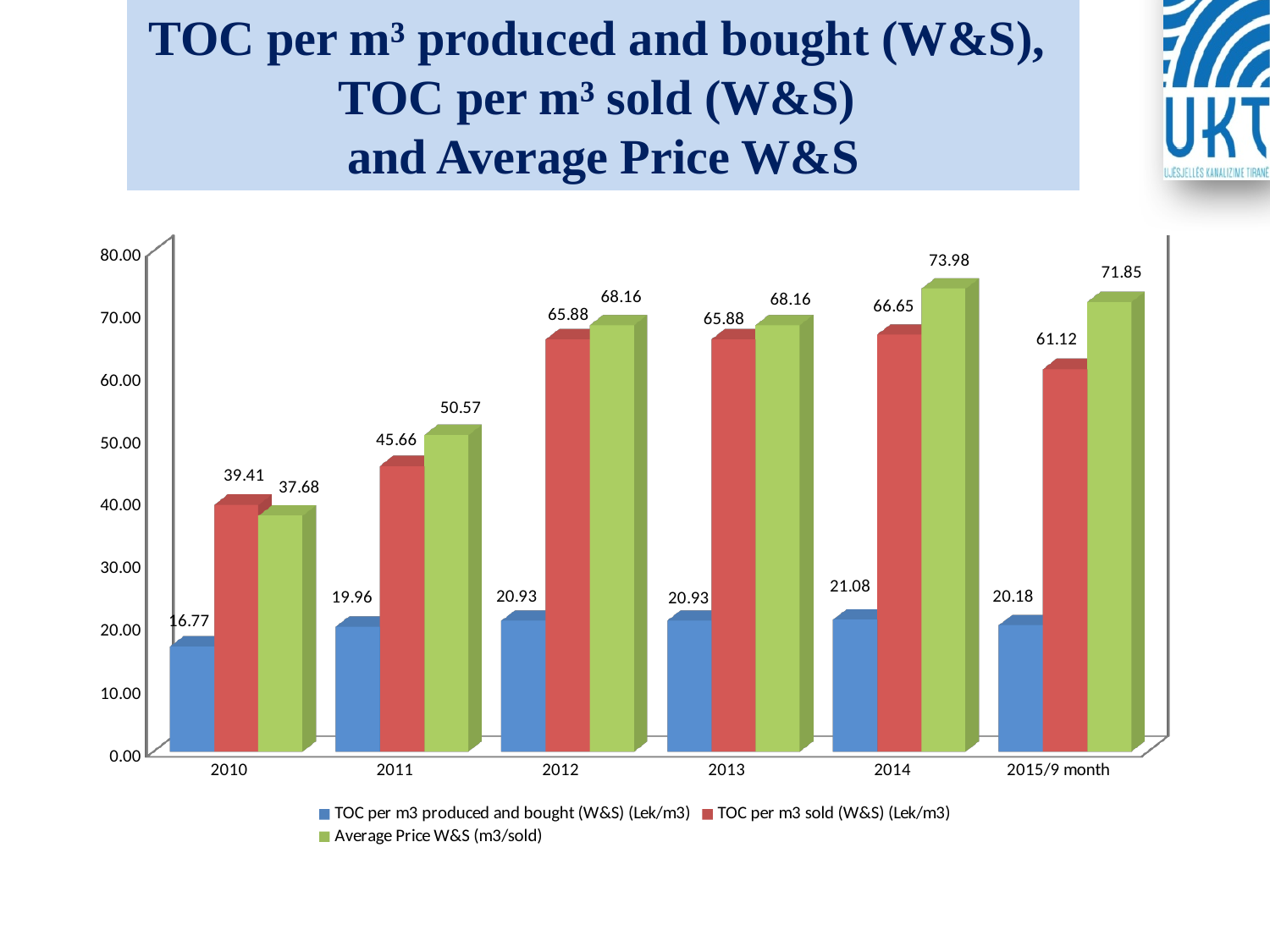
In which year is the Average Price W&S (m3/sold) highest? 2014 How many series does the legend list? 3 What is the value of TOC per m3 sold (W&S) (Lek/m3) for 2014? 66.65 In 2010, which is larger: TOC per m3 sold (W&S) or Average Price W&S? TOC per m3 sold (W&S) How many categories are shown on the x axis? 6 In which year is TOC per m3 produced and bought (W&S) (Lek/m3) lowest? 2010 Does the Average Price W&S (m3/sold) rise or fall from 2010 to 2014? Rise What is the value of TOC per m3 produced and bought (W&S) (Lek/m3) for 2015/9 month? 20.18 What kind of chart is shown on the slide? Bar chart What colour are the bars for Average Price W&S (m3/sold)? Green What is the Average Price W&S (m3/sold) for 2011? 50.57 What is the difference between the Average Price W&S and TOC per m3 sold (W&S) in 2014? 7.33